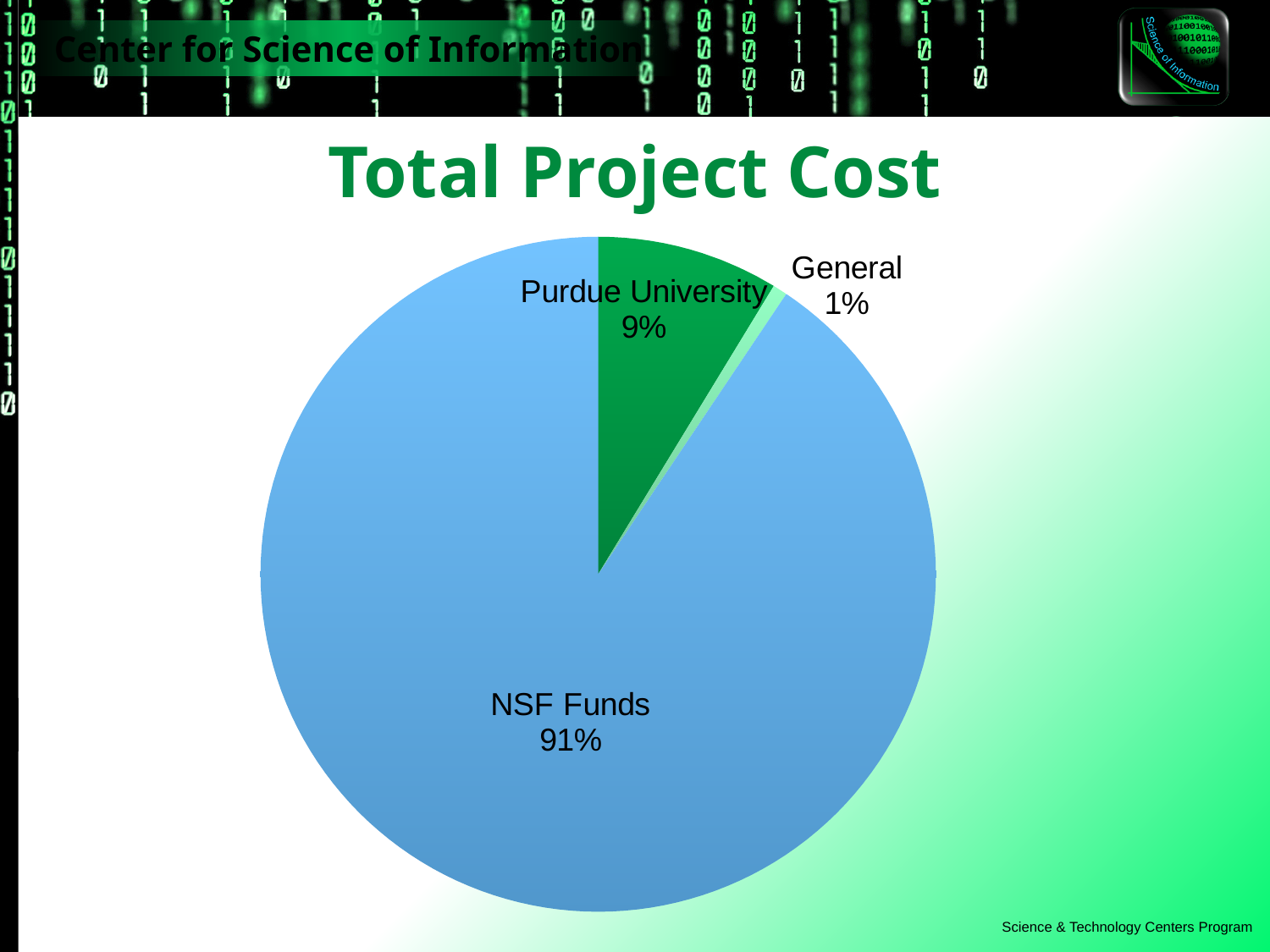
How many slices does the pie chart have? 3 What colour is the NSF Funds slice? blue What is the title of the chart? Total Project Cost What is the difference in percentage points between the NSF Funds share and the Purdue University share? 82 What share of the total project cost is labelled General? 1% Which slice of the pie is the smallest? General Which is larger, the Purdue University share or the General share? Purdue University What share of the total project cost comes from NSF Funds? 91% What share of the total project cost comes from Purdue University? 9% What kind of chart is shown on the slide? pie chart Which slice of the pie is the largest? NSF Funds What is the difference in percentage points between the Purdue University share and the General share? 8